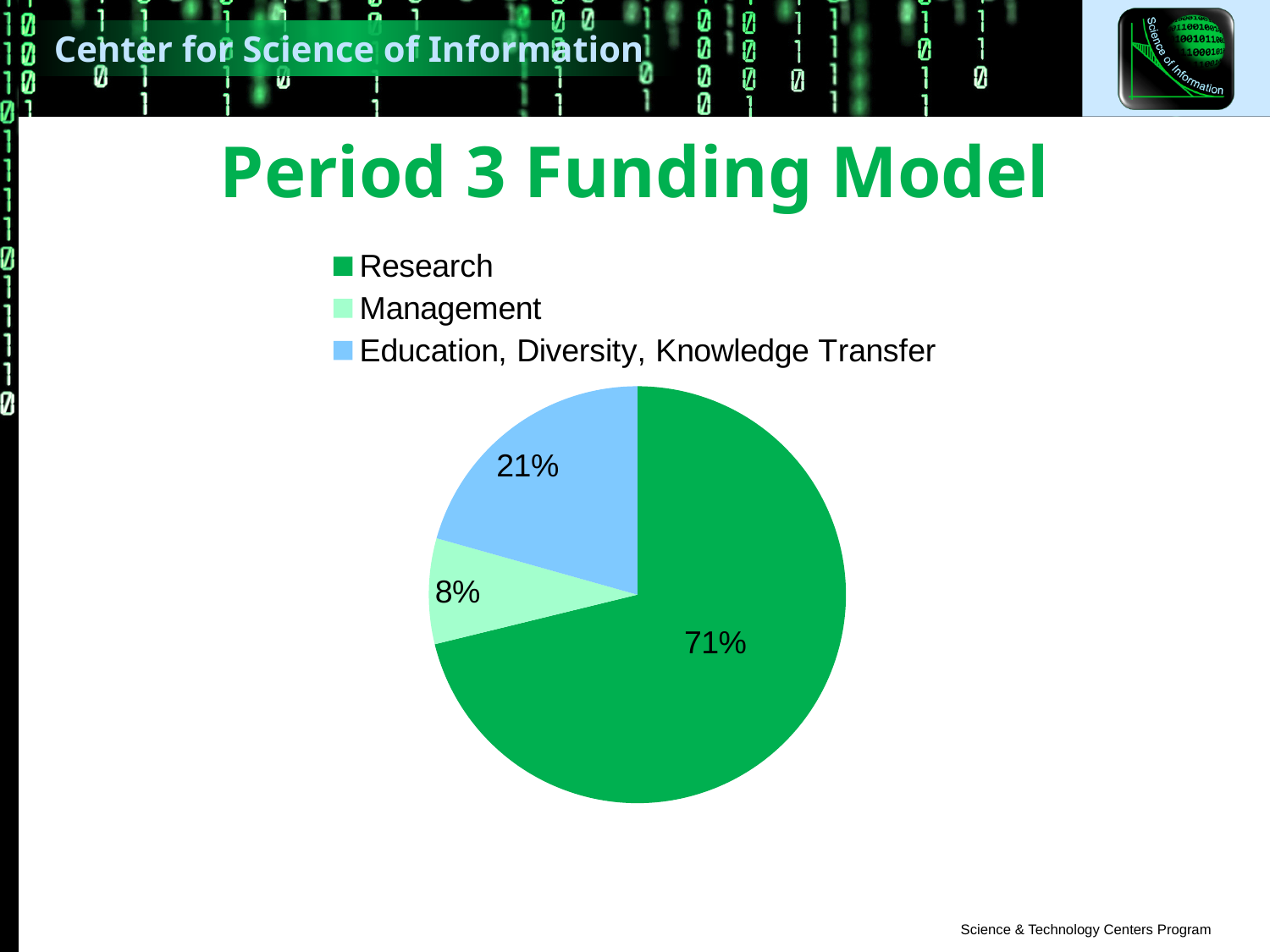
What share of the pie does Research account for? 71% Which is larger, the Management slice or the Education, Diversity, Knowledge Transfer slice? Education, Diversity, Knowledge Transfer How many entries does the legend list? 3 Which category has the smallest slice of the pie? Management What is the difference in percentage points between the Education, Diversity, Knowledge Transfer slice and the Management slice? 13 What is the title of the slide containing the pie chart? Period 3 Funding Model What is the difference in percentage points between the Research slice and the Education, Diversity, Knowledge Transfer slice? 50 What share of the pie does Management account for? 8% Which category has the largest slice of the pie? Research How many slices does the pie chart have? 3 What share of the pie does Education, Diversity, Knowledge Transfer account for? 21% What kind of chart is shown on the slide? pie chart